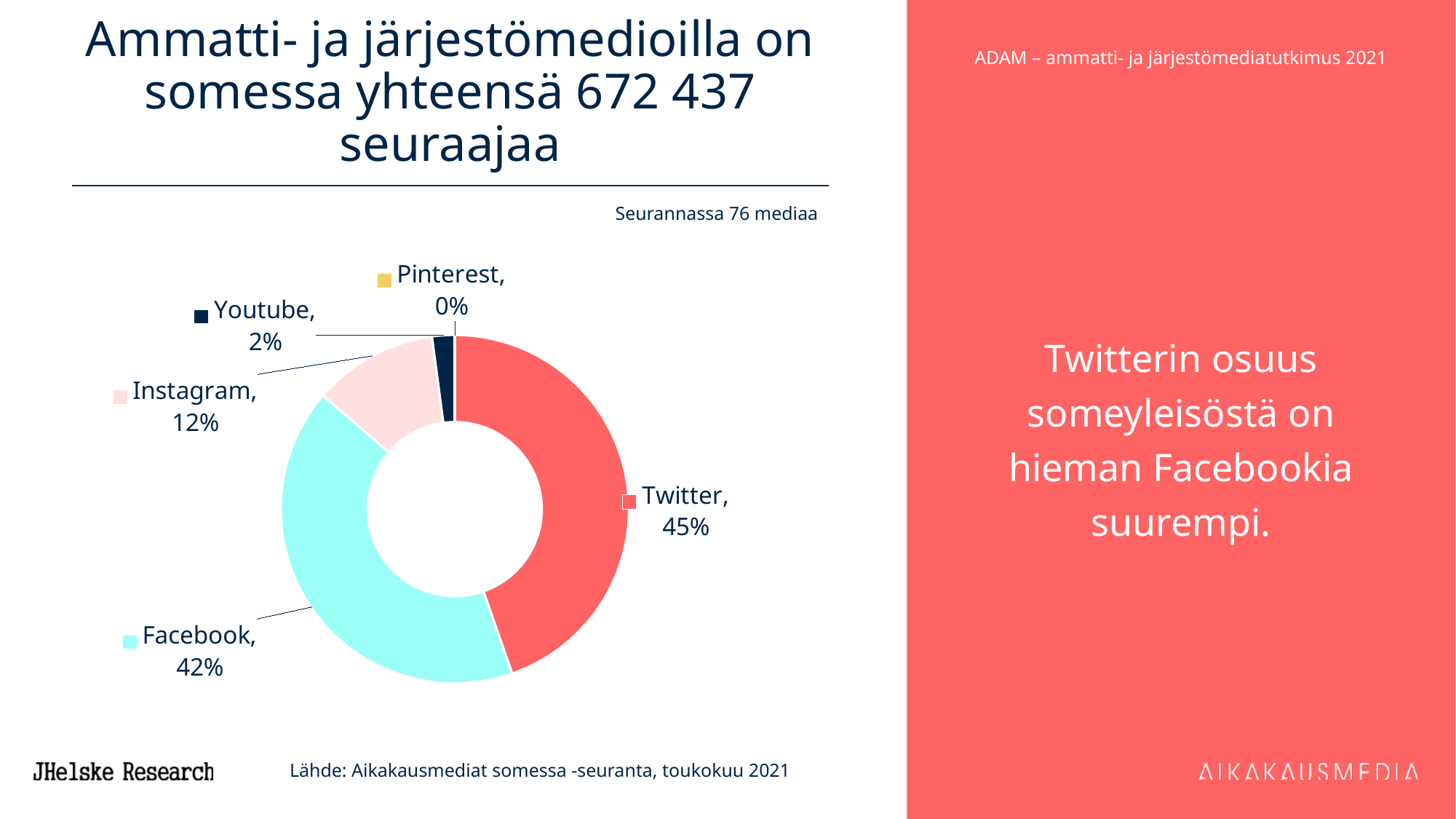
Which platform has the largest share of the audience? Twitter How many platforms are shown in the chart? 5 What kind of chart is shown on the slide? Pie chart (doughnut) Which platform has the smallest share of the audience? Pinterest What share of the social media audience does Youtube have? 2% What is the difference in percentage points between Twitter's and Facebook's shares? 3 percentage points What share is shown for Pinterest? 0% What share of the social media audience does Instagram have? 12% Which has a larger share, Instagram or Youtube? Instagram What share of the social media audience does Facebook have? 42% What colour is the Facebook slice? Light cyan